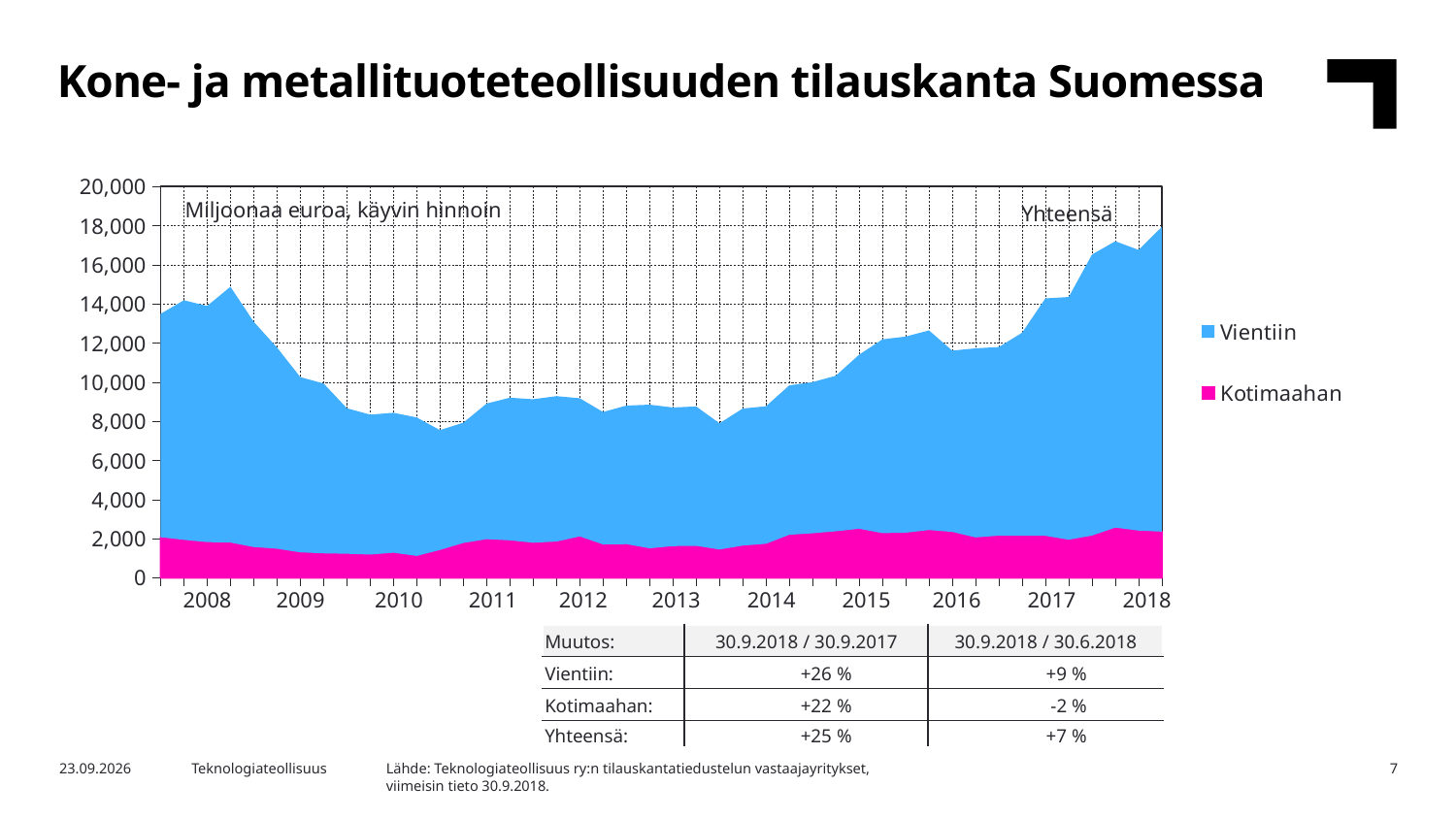
How many year labels are shown on the x axis? 11 What unit is stated in the label inside the chart area? Miljoonaa euroa, käyvin hinnoin Does the total order backlog rise or fall from 2008 to 2010? fall What kind of chart is shown on the slide? Area chart Is the Kotimaahan value in 2010 greater or less than 2,000? less Is the total (Yhteensä) value at the end of 2018 greater or less than 16,000? greater Is the total (Yhteensä) value at the start of 2008 greater or less than 12,000? greater Does the total order backlog rise or fall from 2013 to 2018? rise In 2018, which series is larger, Vientiin or Kotimaahan? Vientiin Which two series are listed in the legend? Vientiin and Kotimaahan How many series does the legend list? 2